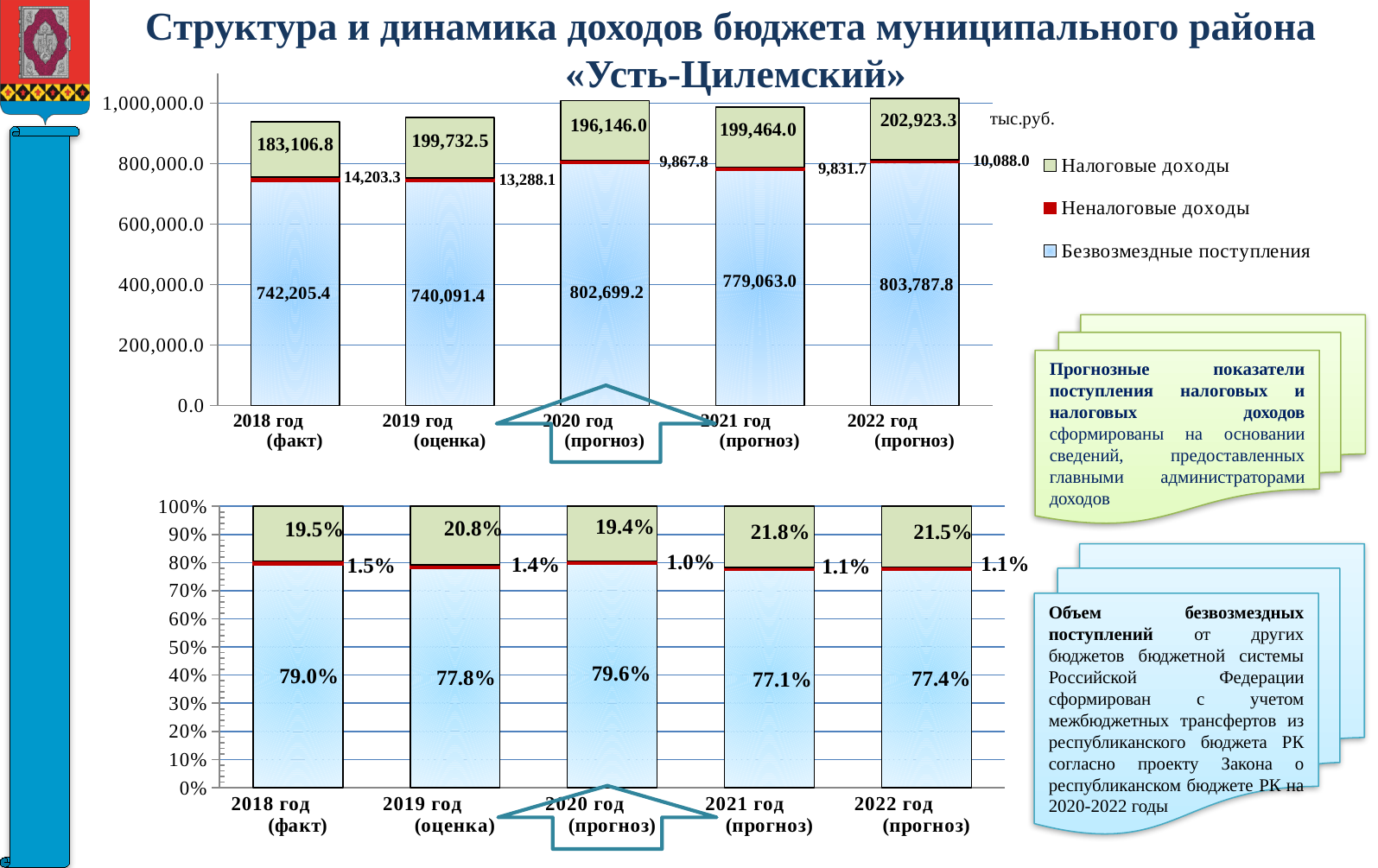
In the top chart, by how much do Налоговые доходы in 2022 год (прогноз) exceed those in 2018 год (факт)? 19,816.5 In the top chart, which is larger: Безвозмездные поступления in 2020 год (прогноз) or in 2021 год (прогноз)? 2020 год (прогноз) In the bottom chart, which year has the lowest share of Неналоговые доходы? 2020 год (прогноз) In the top chart, which year has the lowest value of Безвозмездные поступления? 2019 год (оценка) How many series does the legend of the top chart list? 3 In the top chart, what is the total of the stacked bar for 2018 год (факт)? 939,515.5 In the top chart, what is the value of Налоговые доходы for 2020 год (прогноз)? 196,146.0 How many year categories are shown in the top chart? 5 What type of chart is the bottom chart? Stacked bar chart In the top chart, what is the value of Безвозмездные поступления for 2022 год (прогноз)? 803,787.8 In the top chart, which year has the highest value of Неналоговые доходы? 2018 год (факт) In the bottom chart, what is the share of Налоговые доходы for 2021 год (прогноз)? 21.8%